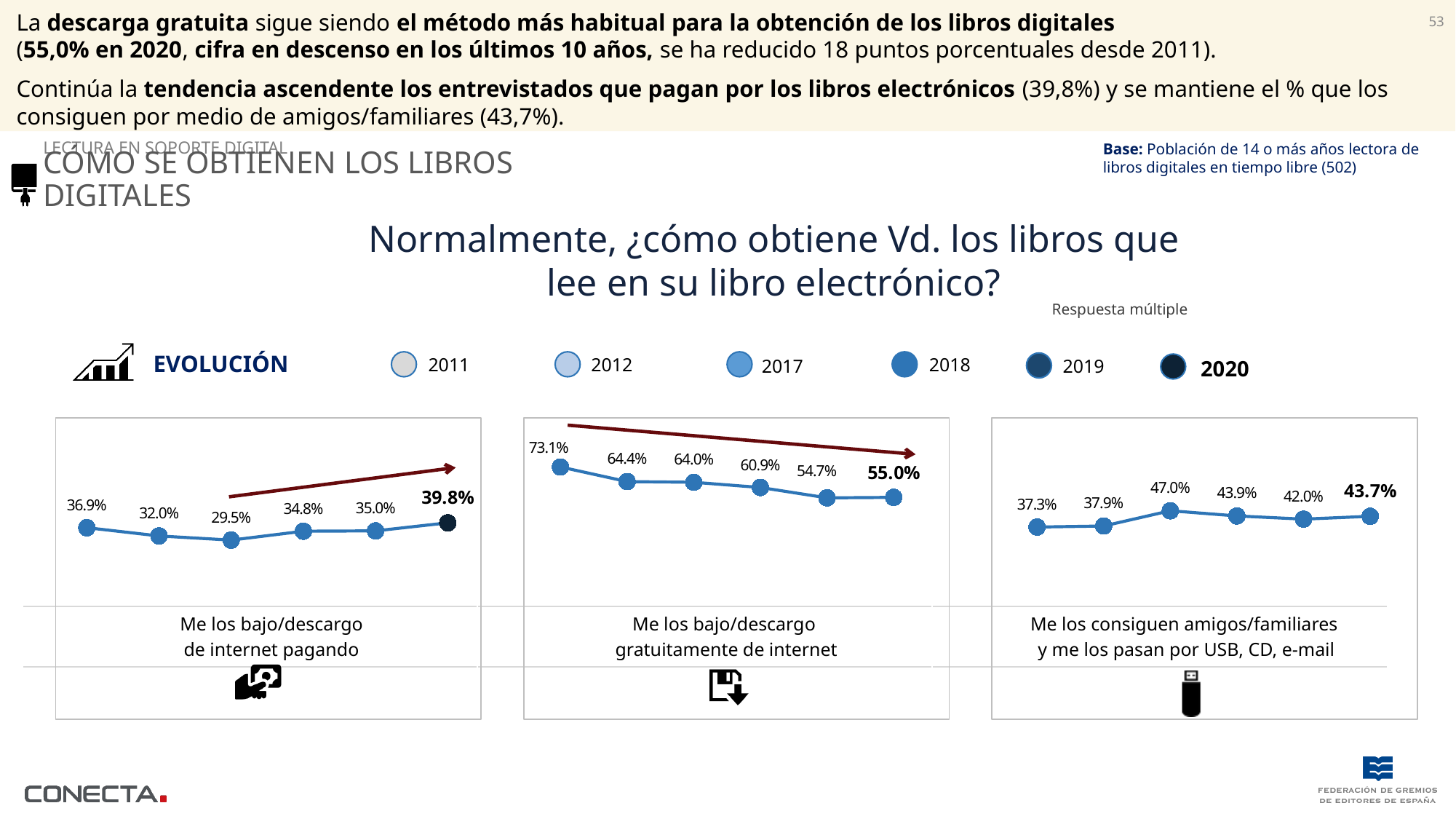
In the chart 'Me los bajo/descargo gratuitamente de internet', which year has the highest value? 2011 In the chart 'Me los consiguen amigos/familiares y me los pasan por USB, CD, e-mail', what is the value for 2017? 47.0% How many data points are plotted in the chart 'Me los bajo/descargo gratuitamente de internet'? 6 In the chart 'Me los consiguen amigos/familiares y me los pasan por USB, CD, e-mail', which year has the lowest value? 2011 In the chart 'Me los bajo/descargo gratuitamente de internet', do the values generally rise or fall from 2011 to 2020? Fall In the chart 'Me los bajo/descargo gratuitamente de internet', what is the difference between the 2011 value and the 2020 value? 18.1 percentage points What kind of chart is used for 'Me los bajo/descargo de internet pagando'? Line chart In the chart 'Me los bajo/descargo de internet pagando', which year has the lowest value? 2017 In the chart 'Me los consiguen amigos/familiares y me los pasan por USB, CD, e-mail', which is larger, the value for 2018 or the value for 2019? 2018 In the chart 'Me los bajo/descargo de internet pagando', what is the value for 2020? 39.8% In the chart 'Me los bajo/descargo de internet pagando', what is the difference between the 2020 value and the 2019 value? 4.8 percentage points In the chart 'Me los bajo/descargo gratuitamente de internet', what is the value for 2011? 73.1%